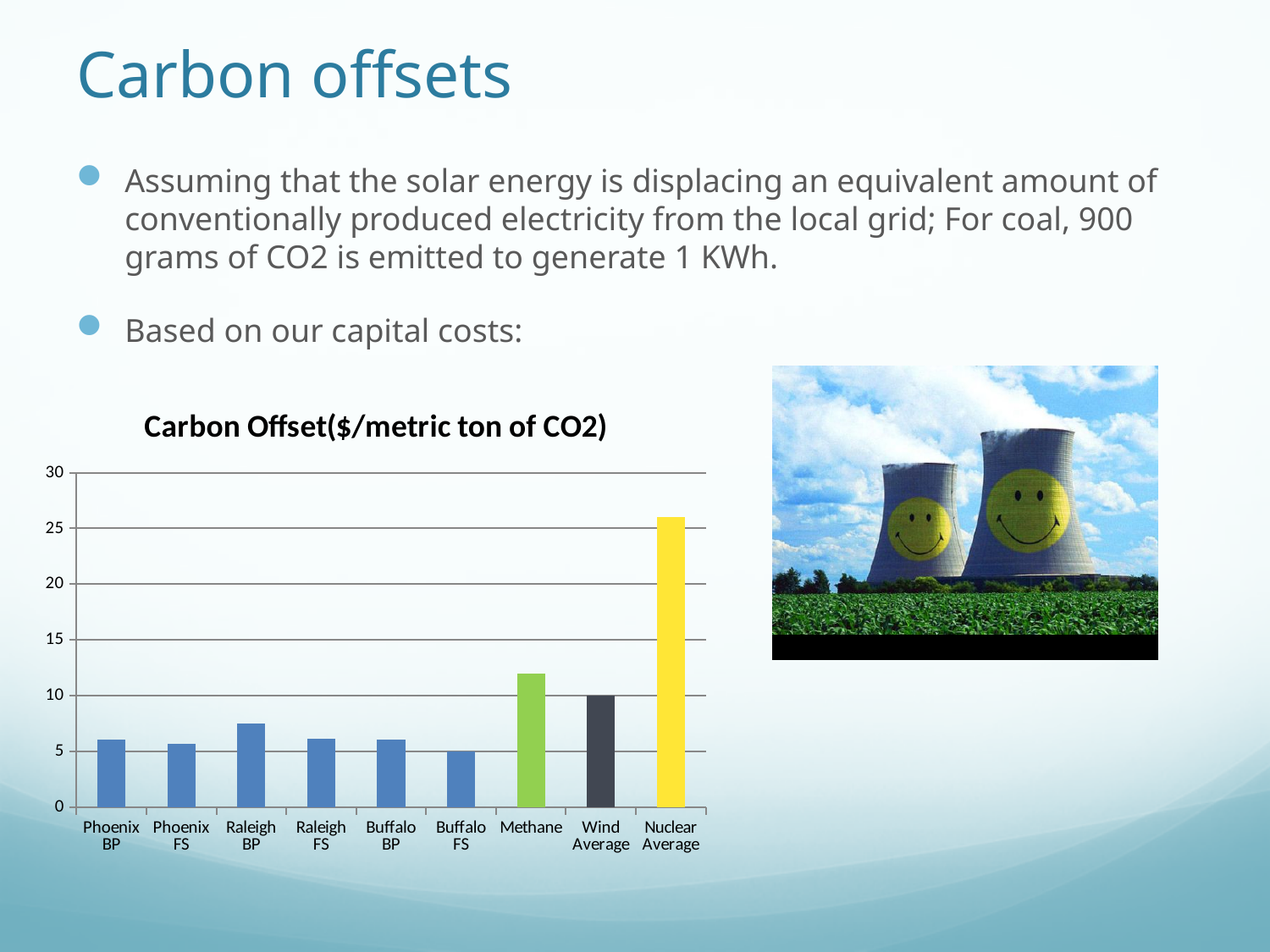
What kind of chart is shown on the slide? bar chart Is the value for Raleigh BP greater or less than 5? greater Is the value for Methane greater or less than 10? greater Which category has the highest carbon offset value? Nuclear Average Which is larger, the value for Methane or the value for Wind Average? Methane What is the title of the chart? Carbon Offset($/metric ton of CO2) Is the value for Buffalo FS greater or less than 10? less How many categories are plotted on the chart? 9 What colour is the bar for Nuclear Average? yellow Which is larger, the value for Nuclear Average or the value for Methane? Nuclear Average Which category has the lowest carbon offset value? Buffalo FS